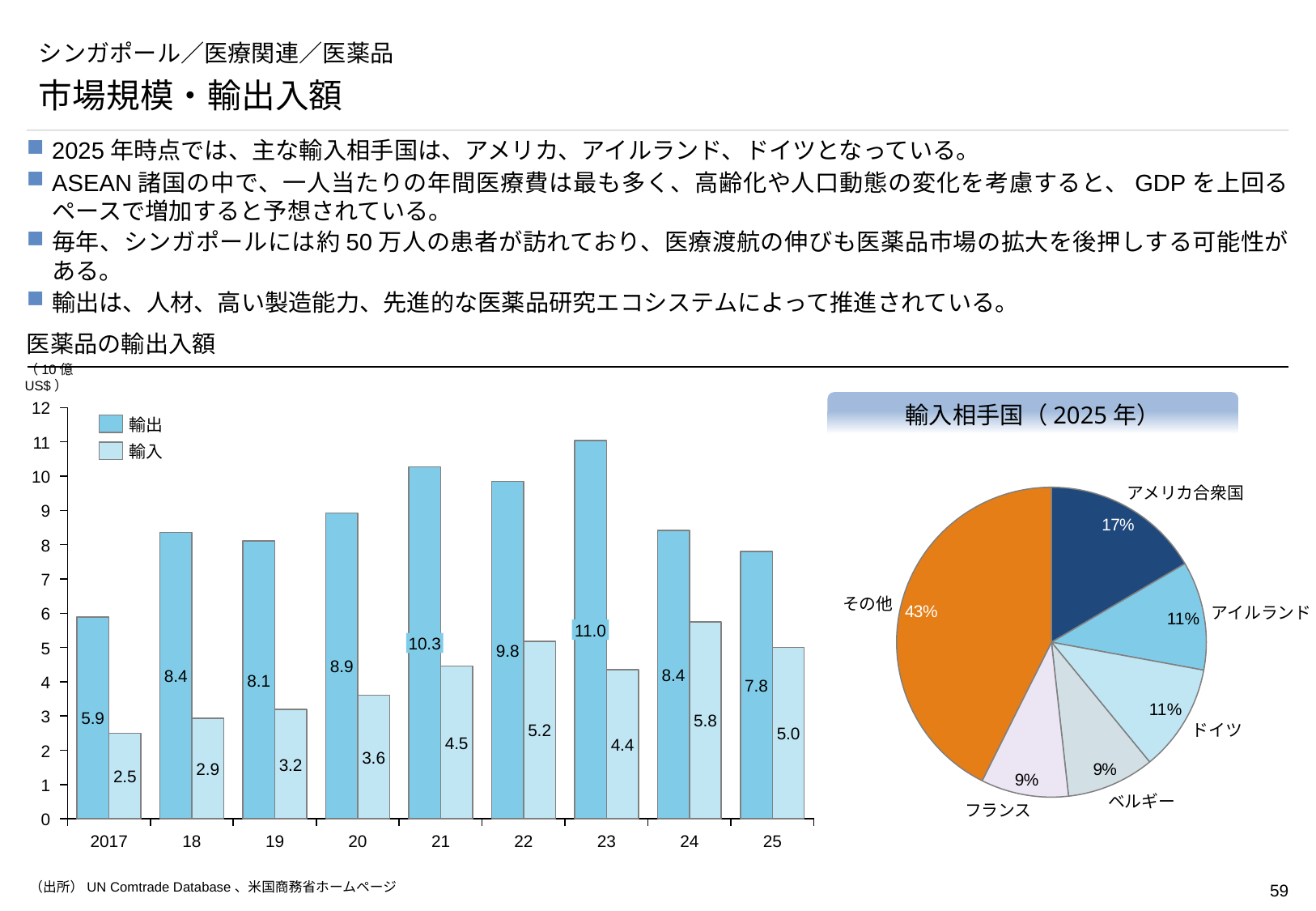
「医薬品の輸出入額」のグラフで、x軸にはいくつの年が表示されていますか？ 9 「医薬品の輸出入額」のグラフで、輸入が最も少ない年はどれですか？ 2017 「輸入相手国（2025年）」の円グラフで、アメリカ合衆国の割合はいくらですか？ 17% 「医薬品の輸出入額」のグラフで、輸出が最も多い年はどれですか？ 23 「輸入相手国（2025年）」の円グラフで、ベルギーの割合はいくらですか？ 9% 「輸入相手国（2025年）」の円グラフで、最も大きい割合を占めるのはどれですか？ その他 「医薬品の輸出入額」のグラフで、2021年の輸出と2022年の輸出ではどちらが大きいですか？ 2021年の輸出 「医薬品の輸出入額」のグラフで、2023年の輸出の値はいくらですか？ 11.0 「医薬品の輸出入額」のグラフは何の種類のグラフですか？ 棒グラフ 「医薬品の輸出入額」のグラフで、凡例にはいくつの系列がありますか？ 2 「医薬品の輸出入額」のグラフで、2017年の輸入の値はいくらですか？ 2.5 「医薬品の輸出入額」のグラフで、2025年の輸出と輸入の差はいくらですか？ 2.8